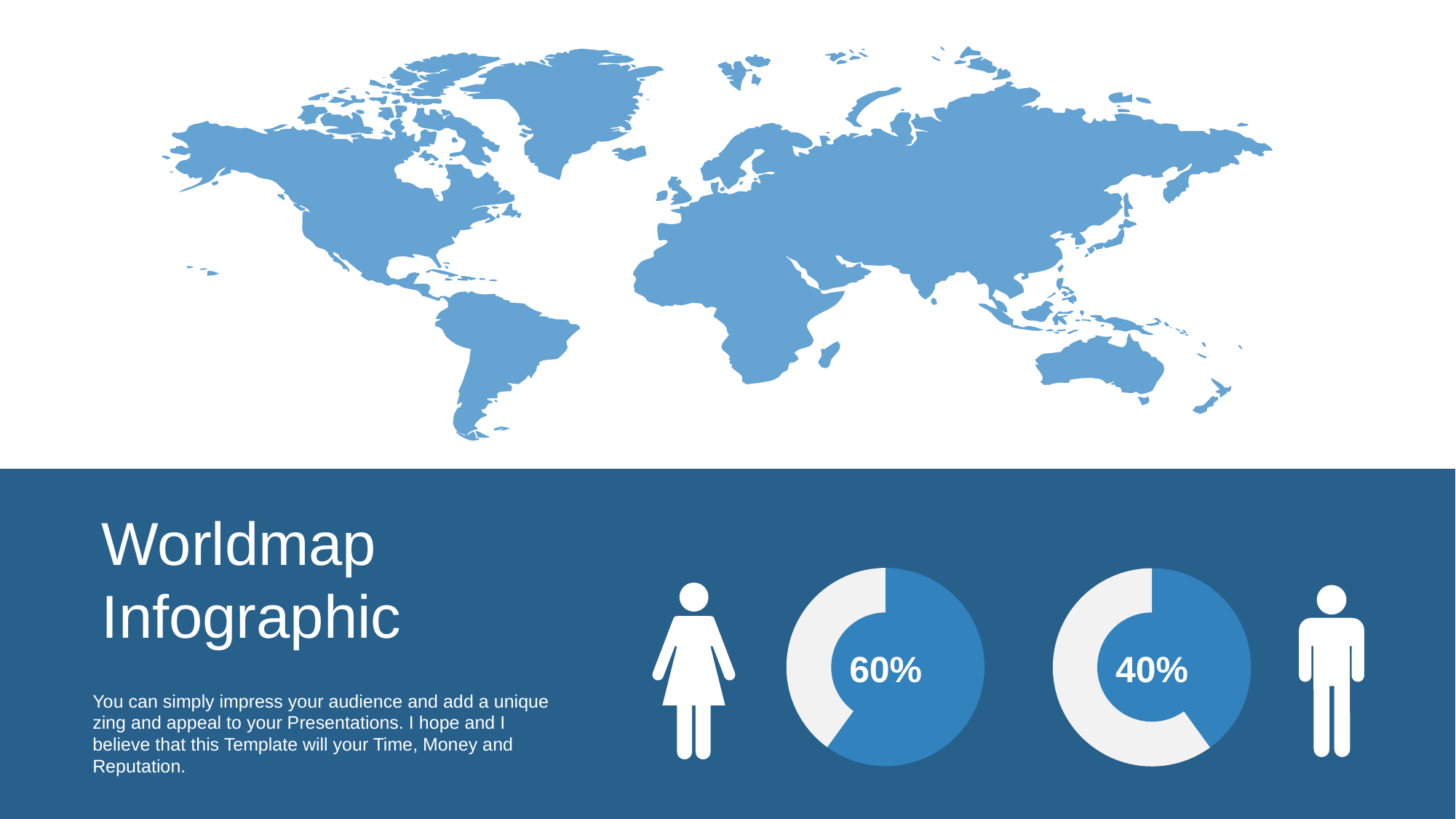
Which donut chart shows the larger percentage, the one next to the female figure or the one next to the male figure? The one next to the female figure What kind of chart is used to display the 60% and 40% values on the slide? Donut chart Is the value in the left donut chart greater or less than 50%? greater How many donut charts are shown on the slide? 2 What percentage is shown in the right donut chart, next to the male figure? 40% What percentage is shown in the left donut chart, next to the female figure? 60% In the right donut chart, what share of the ring is filled in blue? 40% What colour is the filled portion of the donut charts? Blue Is the value in the right donut chart greater or less than 50%? less What is the difference between the percentage in the left donut chart and the percentage in the right donut chart? 20% What is the title of the slide containing the two donut charts? Worldmap Infographic In the left donut chart, what share of the ring is filled in blue? 60%